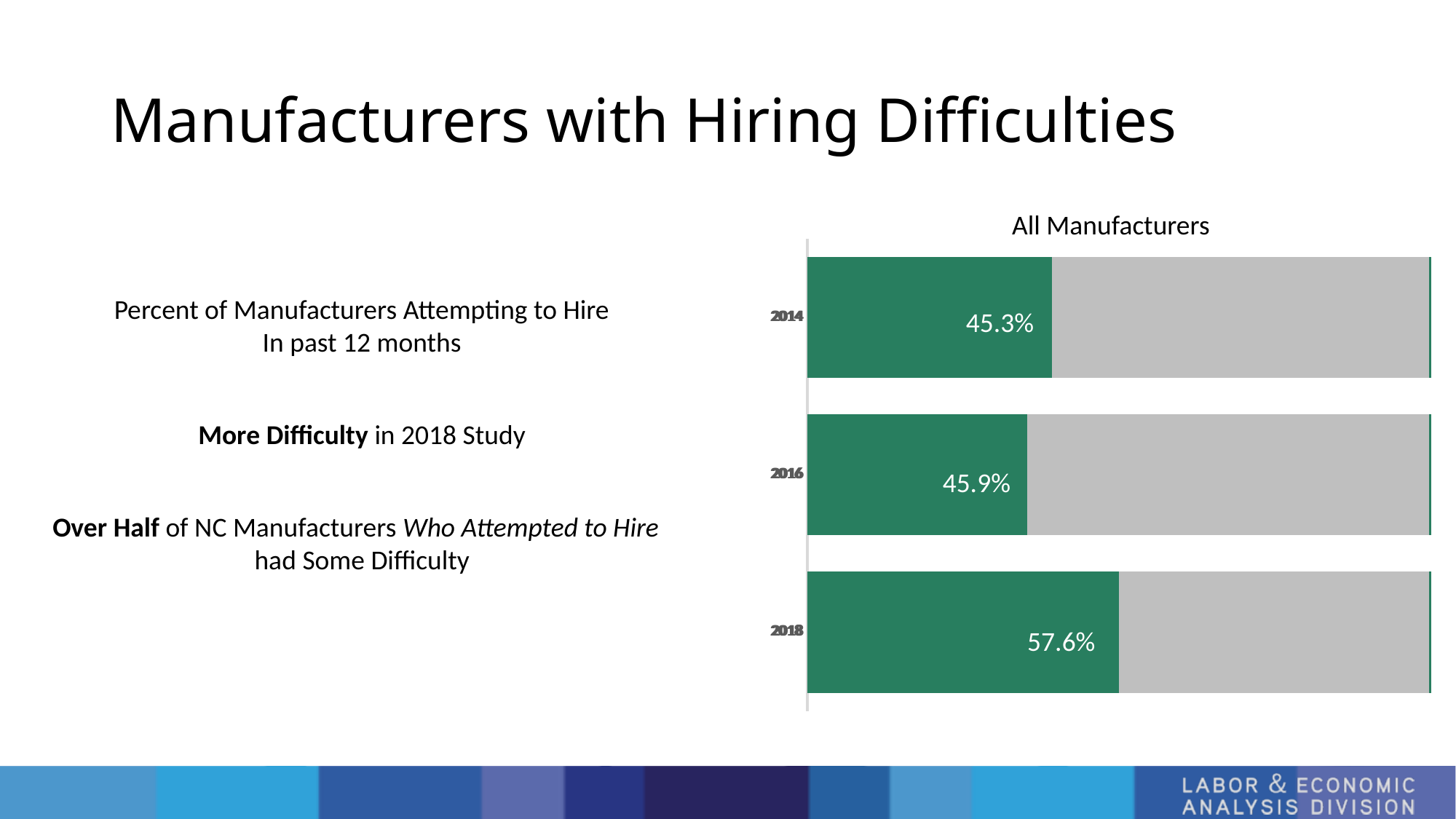
Which is larger, the value for 2018 or the value for 2014? 2018 What is the value for 2014? 45.3% What is the title of the chart? All Manufacturers What kind of chart is shown on the slide? bar chart What is the difference between the 2018 value and the 2014 value? 12.3% How many years are shown in the chart? 3 Which year has the highest value? 2018 What is the value for 2016? 45.9% Do the values rise or fall from 2014 to 2018? rise What colour are the bars showing the percentage values? green What is the difference between the 2018 value and the 2016 value? 11.7% What is the value for 2018? 57.6%